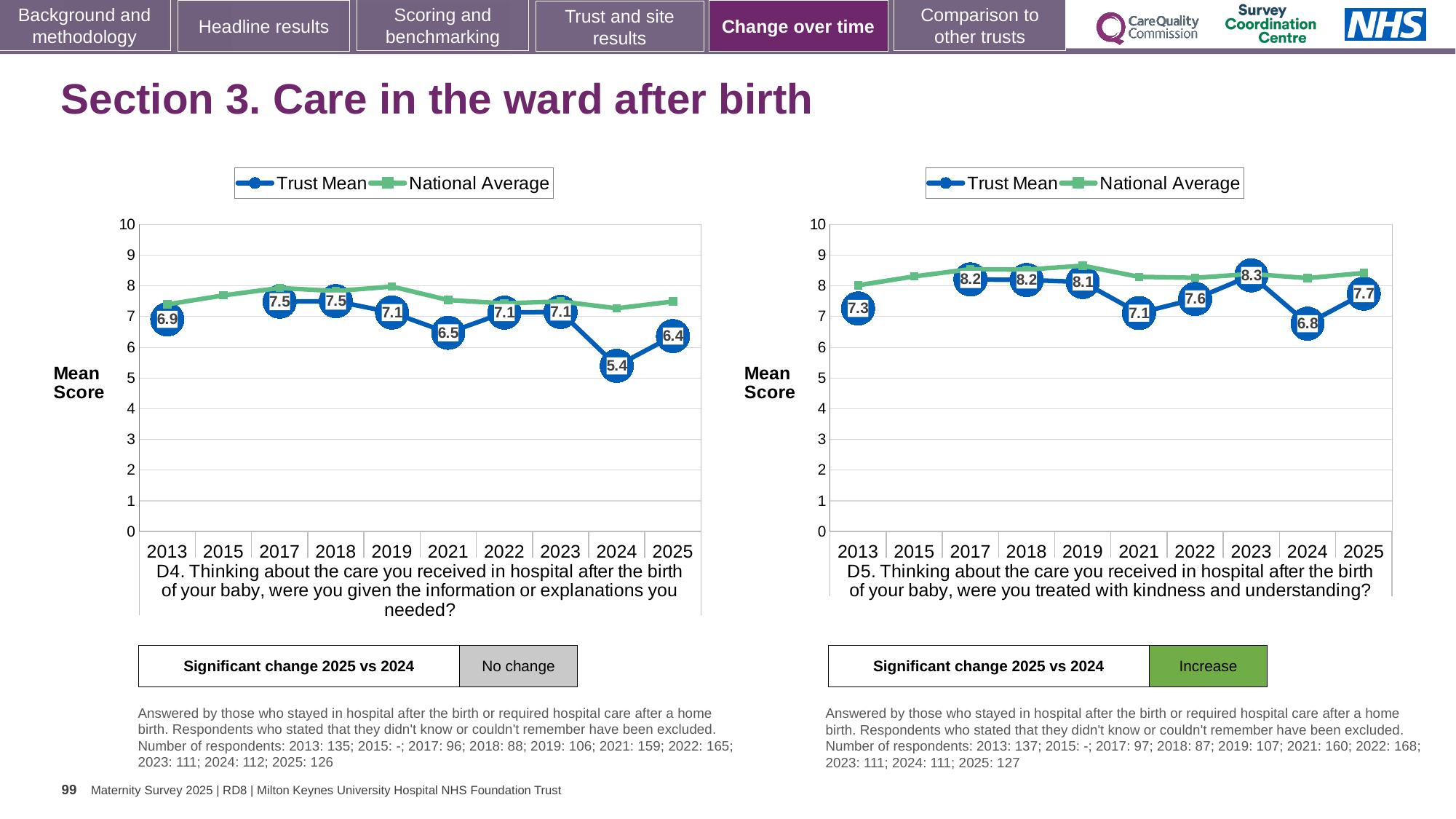
In the D5 chart on the right, is the Trust Mean score for 2021 larger or smaller than the Trust Mean score for 2022? smaller What kind of chart is the D4 chart on the left? Line chart How many series does the legend of the D5 chart on the right list? 2 In the D5 chart on the right, what is the difference between the Trust Mean scores for 2025 and 2024? 0.9 In the D4 chart on the left, which year has the lowest Trust Mean score? 2024 In the D4 chart on the left, what is the Trust Mean score for 2025? 6.4 In the D4 chart on the left, what is the Trust Mean score for 2024? 5.4 In the D4 chart on the left, is the National Average for 2024 greater or less than 7? greater In the D5 chart on the right, which year has the highest Trust Mean score? 2023 In the D5 chart on the right, which year has the lowest Trust Mean score? 2024 In the D5 chart on the right, what is the Trust Mean score for 2023? 8.3 In the D4 chart on the left, what is the difference between the Trust Mean scores for 2025 and 2024? 1.0